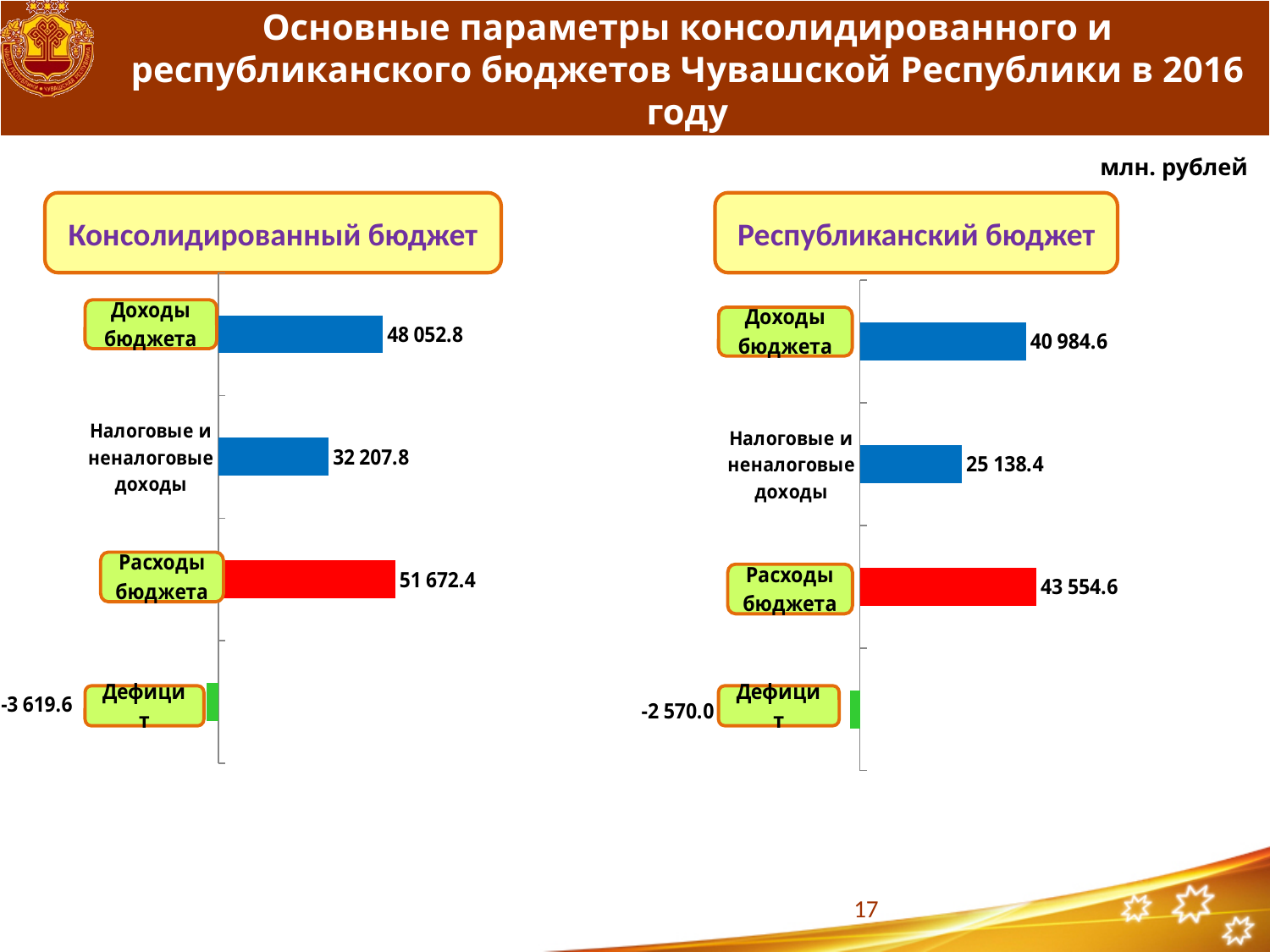
Which is larger: 'Доходы бюджета' in the 'Консолидированный бюджет' chart or 'Доходы бюджета' in the 'Республиканский бюджет' chart? Консолидированный бюджет In the 'Консолидированный бюджет' chart, what is the value for 'Расходы бюджета'? 51 672.4 In the 'Консолидированный бюджет' chart, what colour is the bar for 'Расходы бюджета'? Red In the 'Республиканский бюджет' chart, what is the value for 'Дефицит'? -2 570.0 In the 'Республиканский бюджет' chart, what is the difference between 'Доходы бюджета' and 'Налоговые и неналоговые доходы'? 15 846.2 How many categories are plotted in the 'Республиканский бюджет' chart? 4 What type of chart is the 'Консолидированный бюджет' chart? Bar chart In the 'Консолидированный бюджет' chart, what is the value for 'Доходы бюджета'? 48 052.8 In the 'Консолидированный бюджет' chart, which category has the highest value? Расходы бюджета In the 'Республиканский бюджет' chart, which category has the lowest value? Дефицит In the 'Консолидированный бюджет' chart, what is the difference between 'Расходы бюджета' and 'Доходы бюджета'? 3 619.6 In the 'Республиканский бюджет' chart, what is the value for 'Налоговые и неналоговые доходы'? 25 138.4